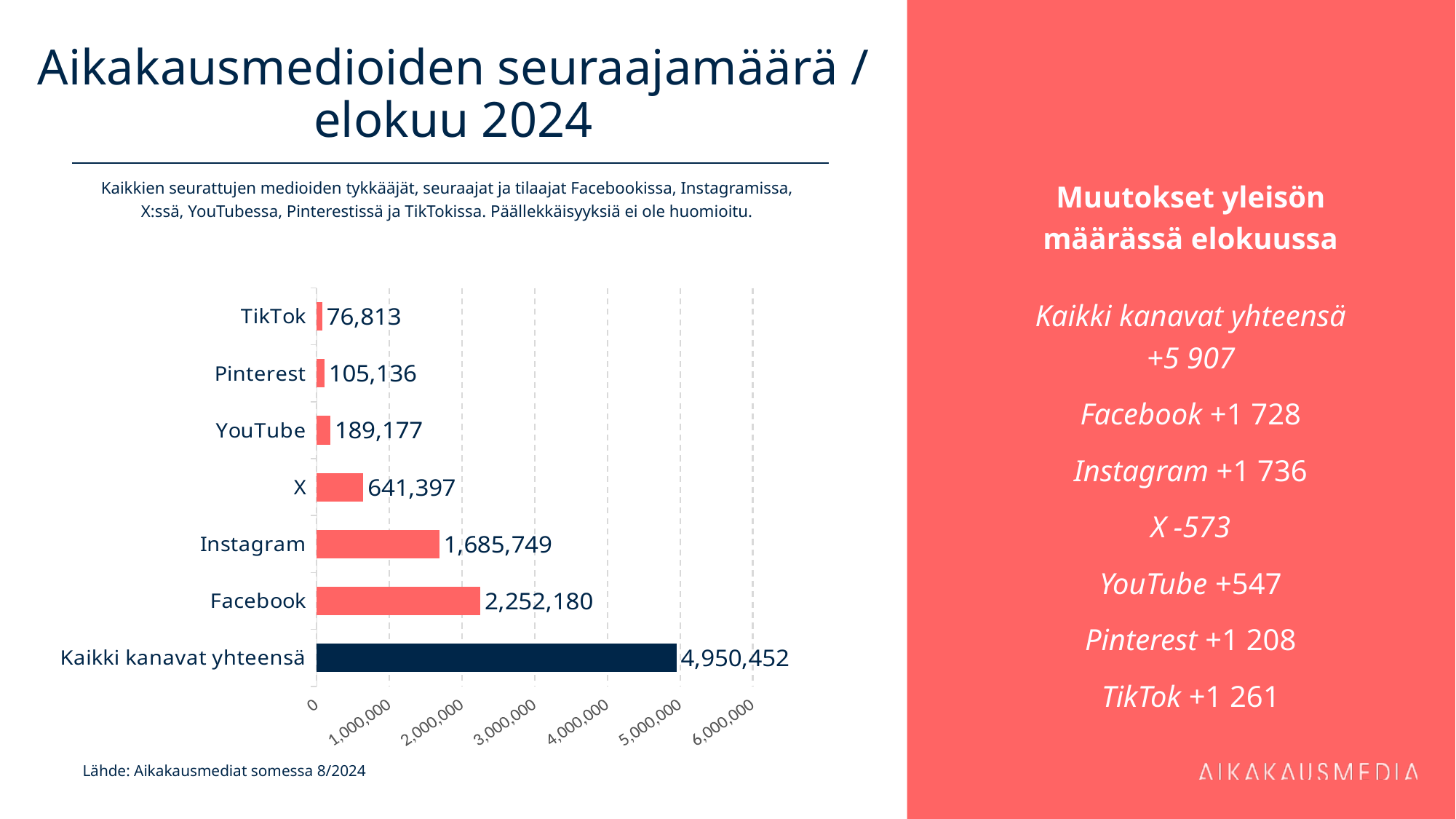
What is the value shown for Kaikki kanavat yhteensä? 4,950,452 Which individual platform (excluding the total bar) has the highest value? Facebook Which category has the lowest value in the chart? TikTok What is the value shown for TikTok? 76,813 What is the value shown for X? 641,397 Which is larger, the value for Pinterest or the value for YouTube? YouTube Is the value for Instagram greater or less than 2,000,000? less What is the difference between the values for X and YouTube? 452,220 What is the difference between the values for Facebook and Instagram? 566,431 What is the value shown for Facebook? 2,252,180 What kind of chart is shown on the slide? Bar chart How many bars are shown in the chart? 7